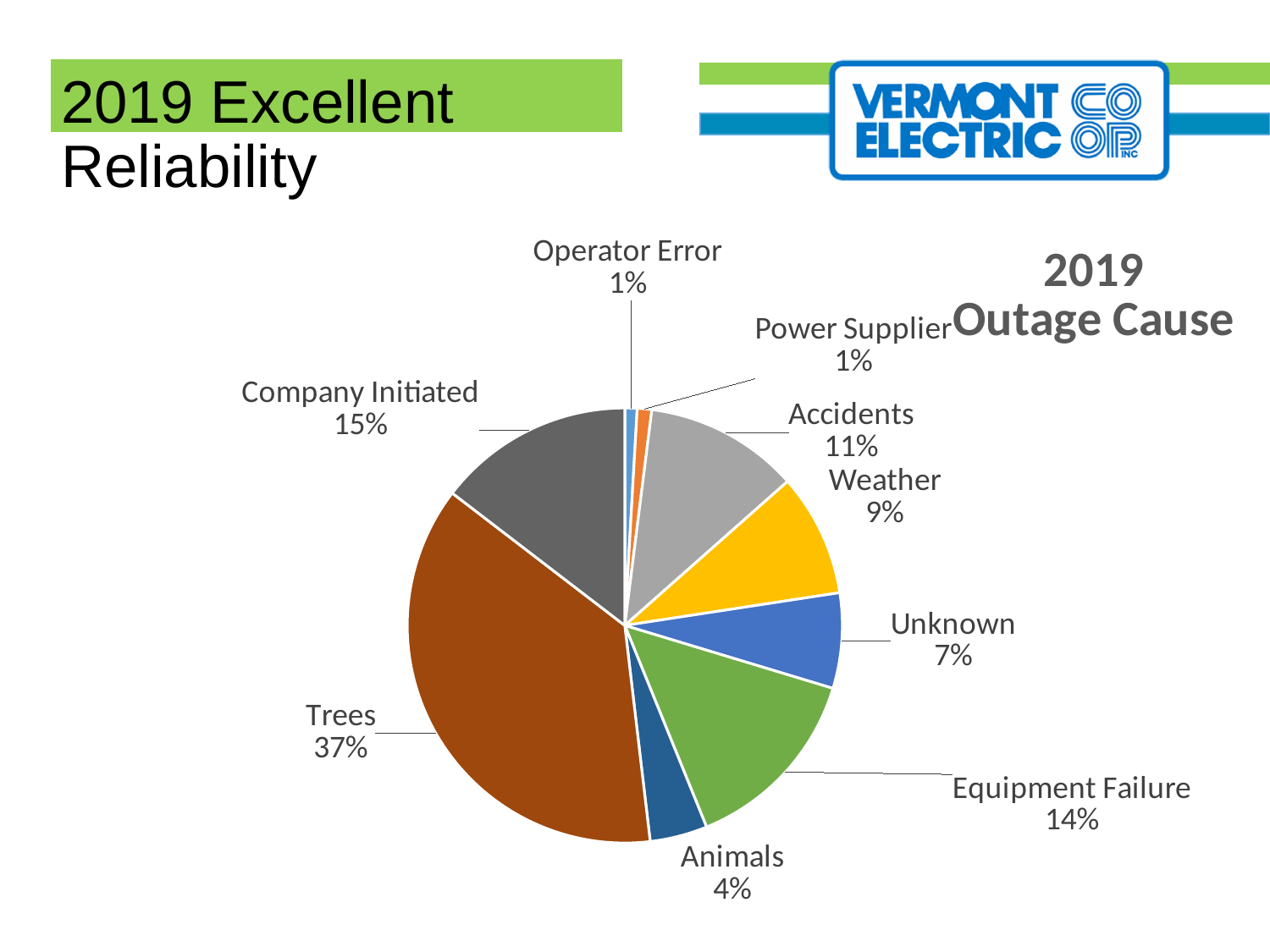
What percentage of outages is labelled Unknown? 7% Which outage cause has the largest share? Trees What share of outages is attributed to Trees? 37% What type of chart is shown on the slide? Pie chart What is the difference in percentage points between Trees and Company Initiated? 22 Which is larger, the share for Animals or the share for Unknown? Unknown What share of outages is attributed to Weather? 9% Which outage cause has a larger share, Company Initiated or Accidents? Company Initiated What is the title of the chart? 2019 Outage Cause What is the difference in percentage points between Accidents and Weather? 2 How many outage causes are shown in the pie chart? 9 What percentage of outages is caused by Equipment Failure? 14%